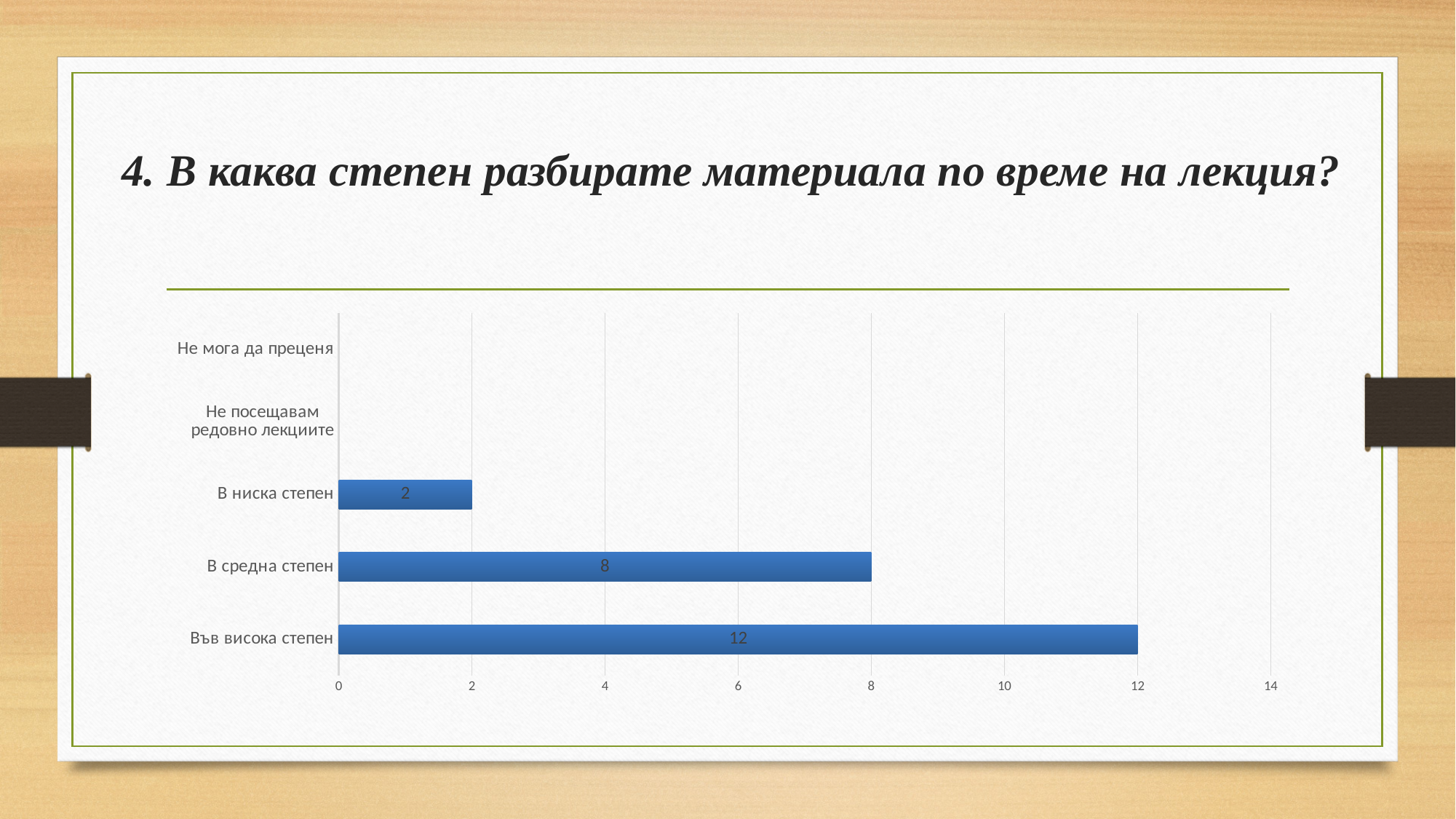
What is the difference between the values for "Във висока степен" and "В средна степен"? 4 What kind of chart is shown on the slide? bar chart What is the question shown as the slide title? 4. В каква степен разбирате материала по време на лекция? What value is shown for "Във висока степен"? 12 Is the value for "В ниска степен" greater or less than 4? less Which category has the largest bar among those with a visible bar, "В ниска степен" or "В средна степен"? В средна степен What value is shown for "В средна степен"? 8 How many categories are listed on the vertical axis of the chart? 5 What is the difference between the values for "В средна степен" and "В ниска степен"? 6 Is the value for "Във висока степен" greater or less than 10? greater What value is shown for "В ниска степен"? 2 Which category has the highest value? Във висока степен